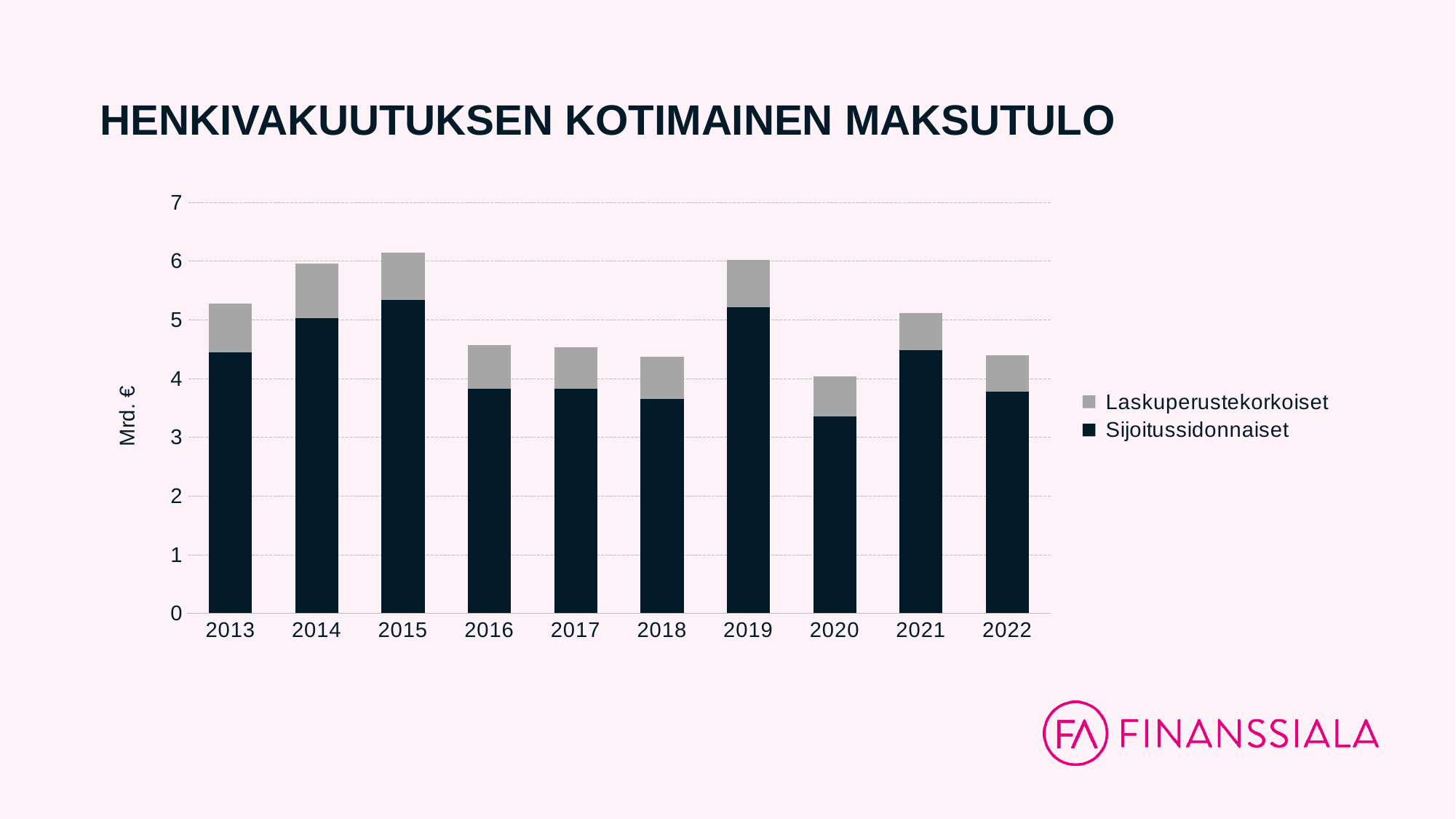
Is the total value for 2015 greater or less than 6? greater Is the Sijoitussidonnaiset value for 2020 greater or less than 4? less How many series does the chart's legend list? 2 Is the total value for 2020 greater or less than 5? less What is the label on the y axis of the chart? Mrd. € What kind of chart is shown on the slide? Stacked bar chart Which year has the highest total bar in the chart? 2015 How many years are shown on the x axis of the chart? 10 Which year has the larger total bar, 2014 or 2016? 2014 Which year has the lowest total bar in the chart? 2020